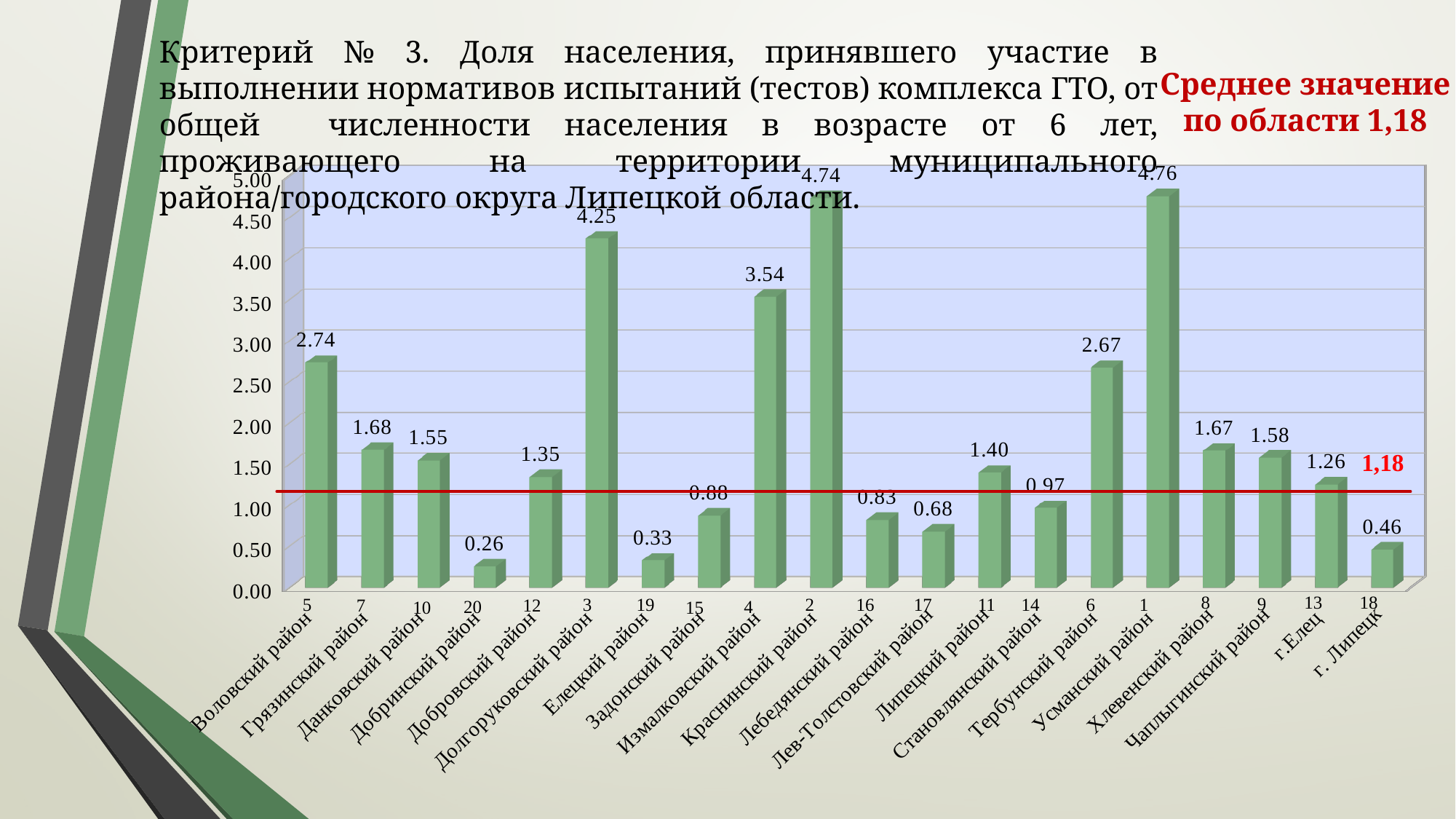
What is the value for Краснинский район? 4.74 What is the difference between the values for Усманский район and Добринский район? 4.50 What kind of chart is shown on the slide? bar chart Is the value for Измалковский район greater or less than 3.00? greater What is the value for г. Липецк? 0.46 Which district has the lowest value? Добринский район Which has a larger value, Долгоруковский район or Измалковский район? Долгоруковский район What value does the red horizontal line on the chart mark? 1,18 What is the value for Липецкий район? 1.40 What is the value for Воловский район? 2.74 Which district has the highest value? Усманский район How many districts/cities are shown on the chart? 20